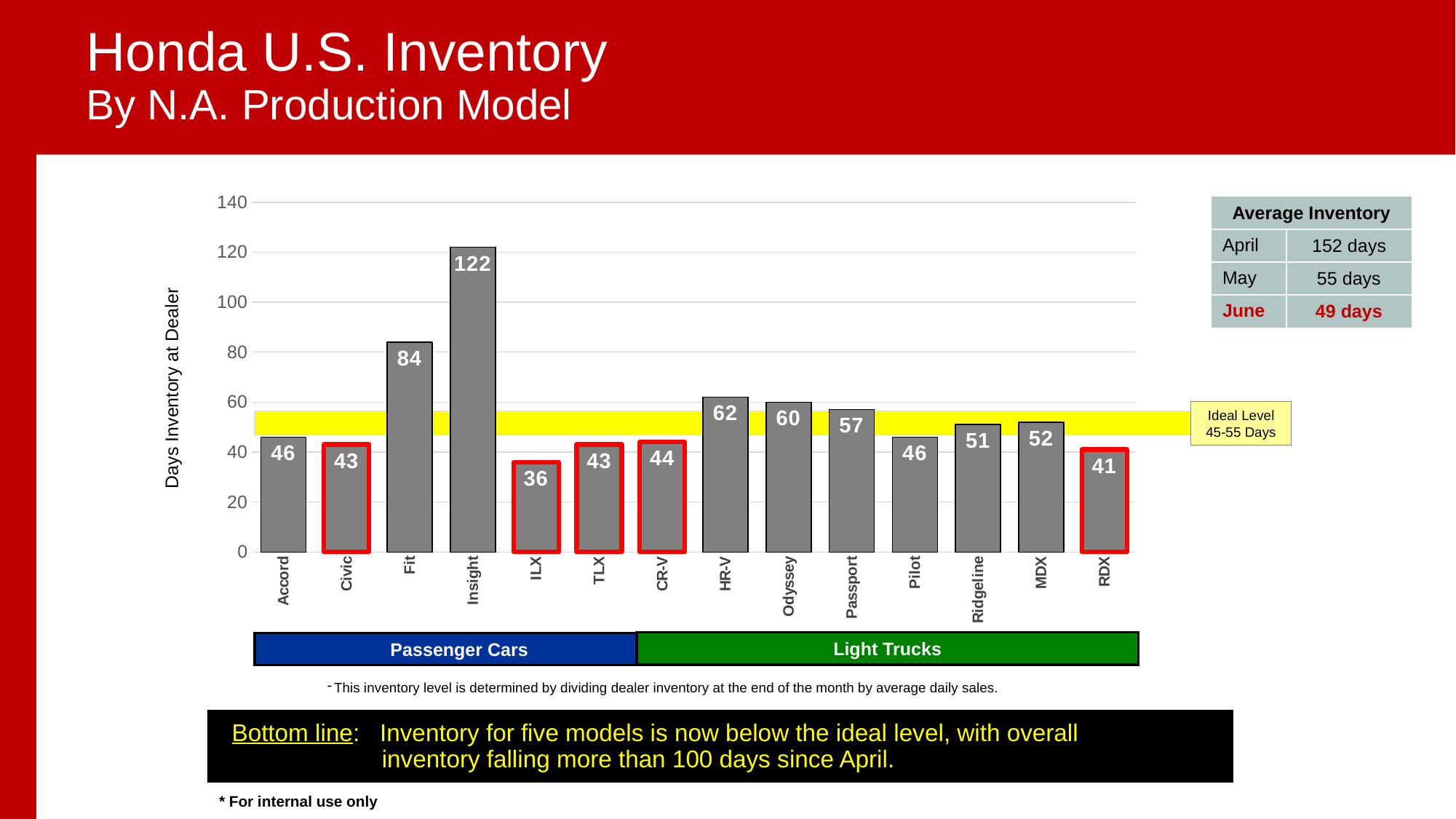
Is the value for Fit greater or less than 80? greater What is the difference in days inventory between Insight and Fit? 38 What is the days inventory at dealer for ILX? 36 What is the days inventory at dealer for Odyssey? 60 How many models are shown on the chart? 14 What range does the yellow band on the chart mark as the ideal level? 45-55 Days What kind of chart is shown on the slide? Bar chart Which has a higher days inventory at dealer, HR-V or Pilot? HR-V Which model has the lowest days inventory at dealer? ILX Which model has the highest days inventory at dealer? Insight What is the label of the vertical axis? Days Inventory at Dealer What is the days inventory at dealer for Insight? 122